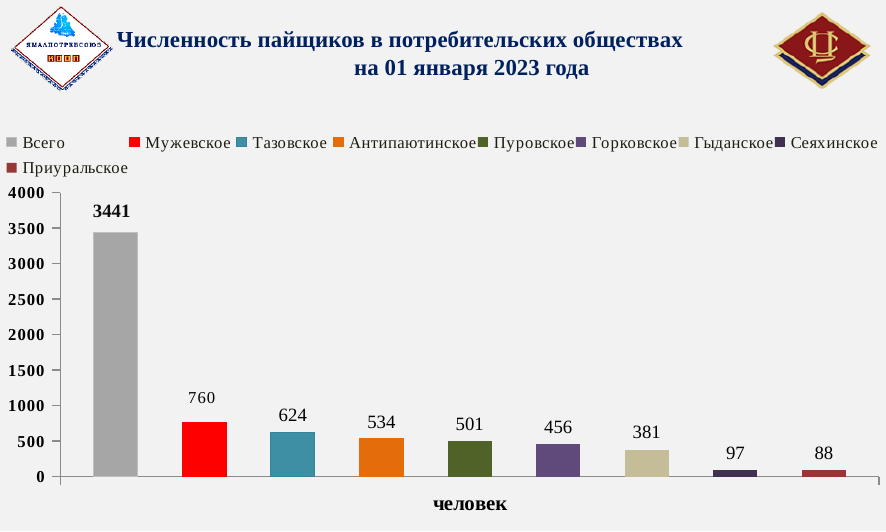
What is the value for Мужевское? 760 What is the value for Гыданское? 381 Excluding Всего, which category has the highest value? Мужевское Which is larger, the value for Пуровское or the value for Горковское? Пуровское Which category has the lowest value? Приуральское What kind of chart is shown on the slide? bar chart What is the value for Всего? 3441 What is the label shown below the x axis of the chart? человек Is the value for Сеяхинское greater or less than 500? less How many bars are shown in the chart? 9 How many entries does the legend list? 9 What is the difference between the values for Тазовское and Антипаютинское? 90